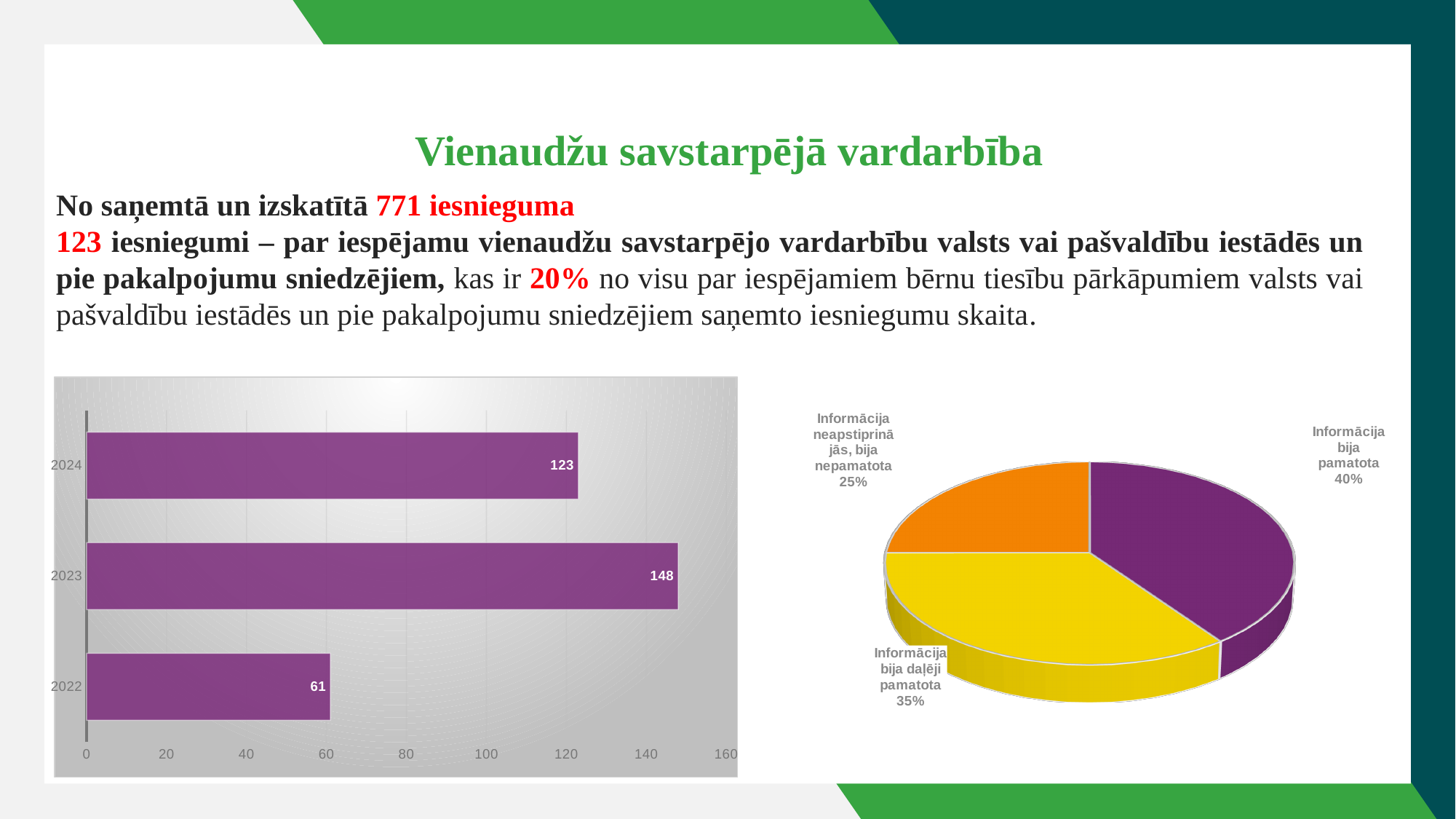
In the bar chart on the left of the slide, how many years are shown? 3 In the bar chart on the left of the slide, which year has the highest value? 2023 In the bar chart on the left of the slide, which is larger, the value for 2022 or the value for 2024? 2024 In the bar chart on the left of the slide, what is the value for 2024? 123 In the pie chart on the right of the slide, how many slices are there? 3 In the bar chart on the left of the slide, what is the difference between the values for 2023 and 2024? 25 In the bar chart on the left of the slide, which year has the lowest value? 2022 In the pie chart on the right of the slide, what share does 'Informācija neapstiprinājās, bija nepamatota' have? 25% In the pie chart on the right of the slide, which slice is the largest? Informācija bija pamatota What kind of chart is on the left of the slide? Bar chart In the bar chart on the left of the slide, what is the value for 2022? 61 In the pie chart on the right of the slide, what share does 'Informācija bija pamatota' have? 40%